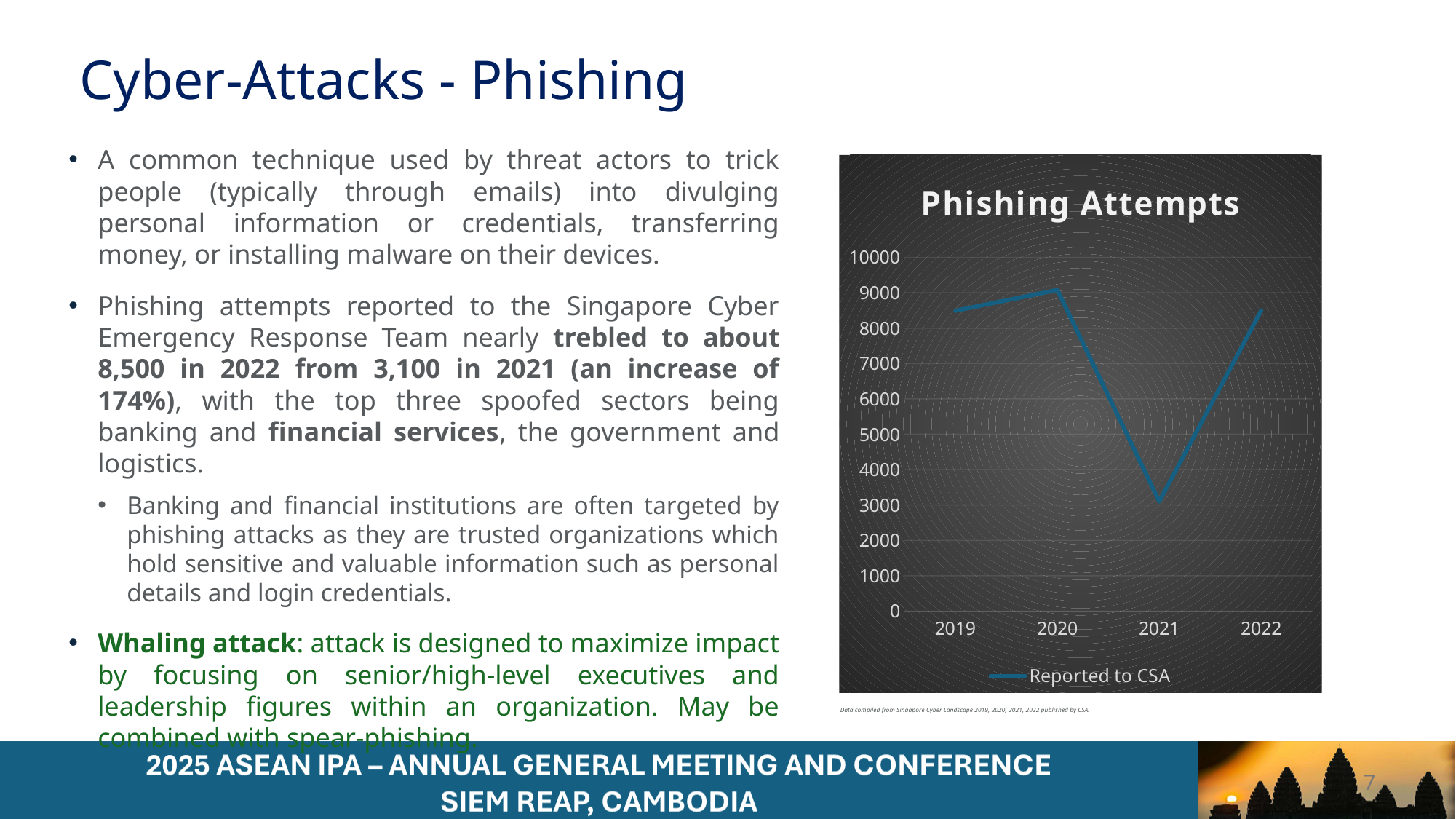
Is the value for 2019 greater or less than 8000? greater What is the name of the series shown in the chart legend? Reported to CSA Is the value for 2021 greater or less than 4000? less What type of chart is shown on the slide? Line chart Which year has the highest number of phishing attempts reported to CSA? 2020 Is the value for 2022 greater or less than 9000? less What is the title of the chart? Phishing Attempts Does the number of phishing attempts rise or fall from 2020 to 2021? Fall How many years are plotted on the x axis of the chart? 4 Which year has a larger value, 2019 or 2021? 2019 Which year has the lowest number of phishing attempts reported to CSA? 2021 How many series does the chart legend list? 1